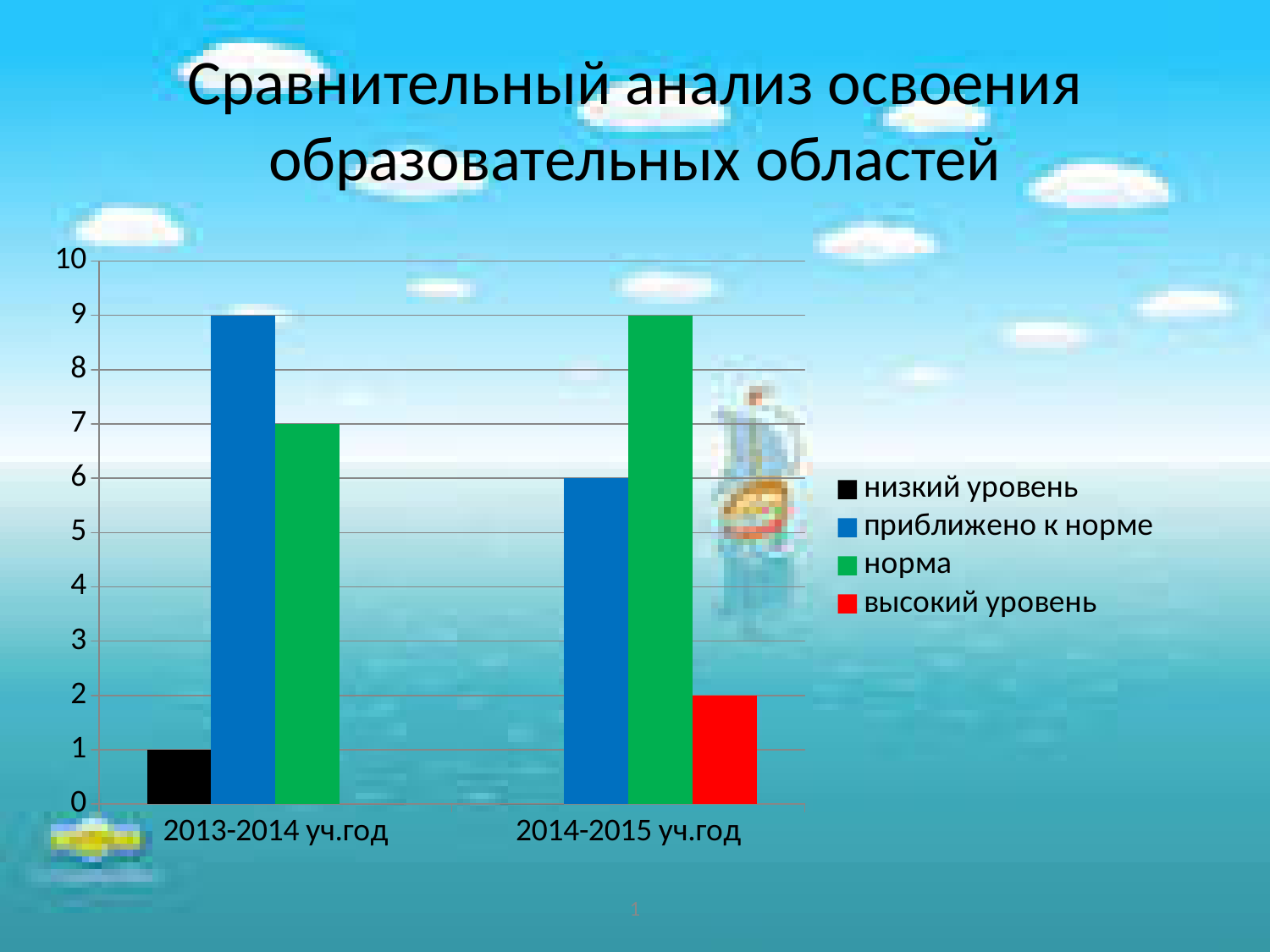
What is the value for 'норма' in 2013-2014 уч.год? 7 What is the value for 'высокий уровень' in 2014-2015 уч.год? 2 Which colour represents 'высокий уровень' in the legend? red Which series has the lowest value in 2013-2014 уч.год? высокий уровень Which series has the highest value in 2014-2015 уч.год? норма How many categories are shown on the x axis? 2 What is the value for 'норма' in 2014-2015 уч.год? 9 How many series does the legend list? 4 What is the value for 'приближено к норме' in 2013-2014 уч.год? 9 What is the value for 'низкий уровень' in 2013-2014 уч.год? 1 What type of chart is shown on the slide? bar chart What is the difference between 'приближено к норме' in 2013-2014 уч.год and in 2014-2015 уч.год? 3